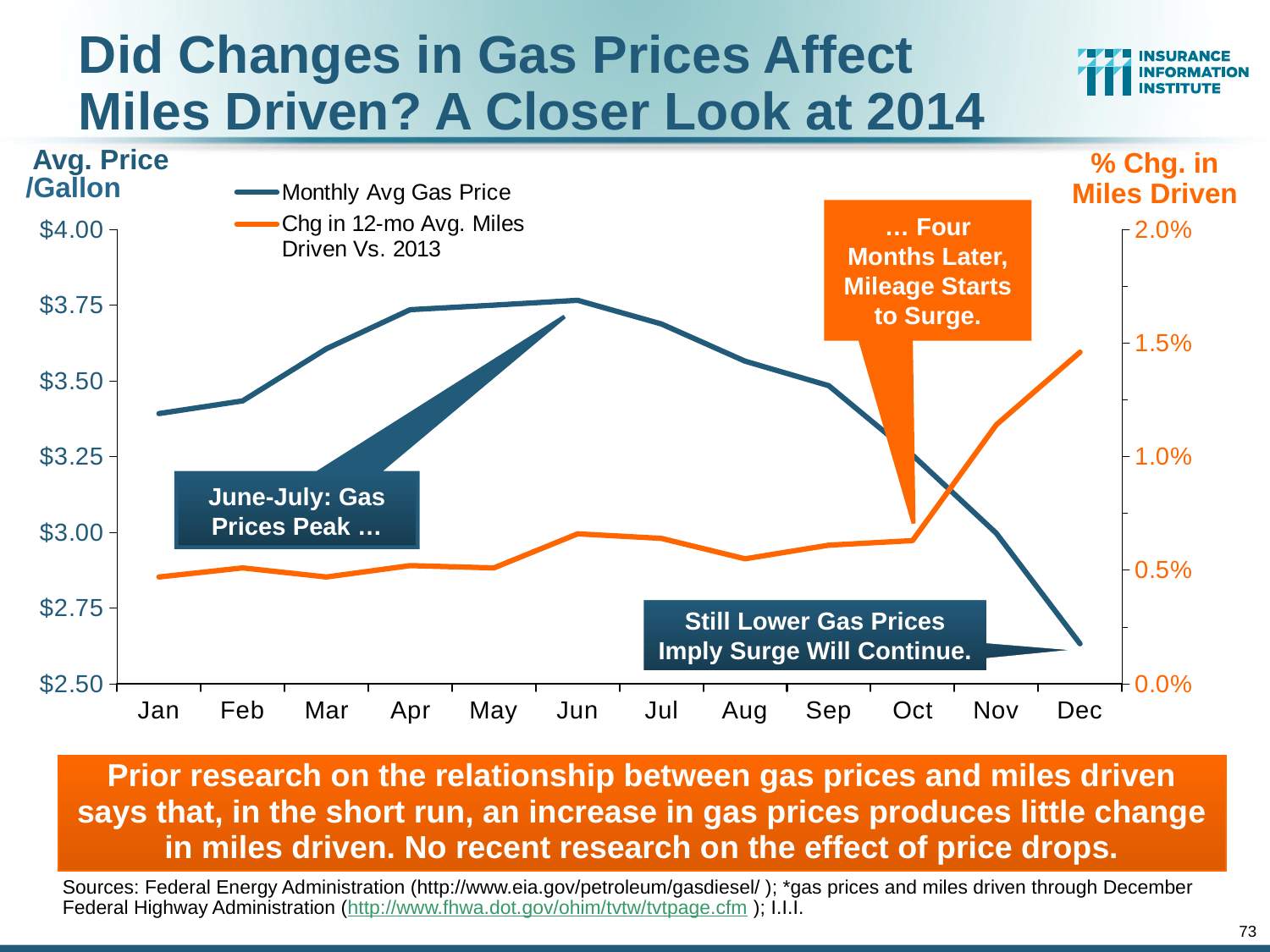
What kind of chart is shown on the slide? line chart Does the Monthly Avg Gas Price rise or fall from Jun to Dec? fall How many series does the legend list? 2 Is the Chg in 12-mo Avg. Miles Driven Vs. 2013 for Dec greater or less than 1.0%? greater In which month is the Monthly Avg Gas Price lowest? Dec Is the Monthly Avg Gas Price for Dec greater or less than $2.75? less In which month is the Monthly Avg Gas Price highest? Jun In which month is the Chg in 12-mo Avg. Miles Driven Vs. 2013 highest? Dec Which axis label appears on the right side of the chart? % Chg. in Miles Driven Is the Monthly Avg Gas Price for Jan greater or less than $3.50? less Which month has a higher Monthly Avg Gas Price, Apr or Sep? Apr How many months are plotted along the x axis? 12